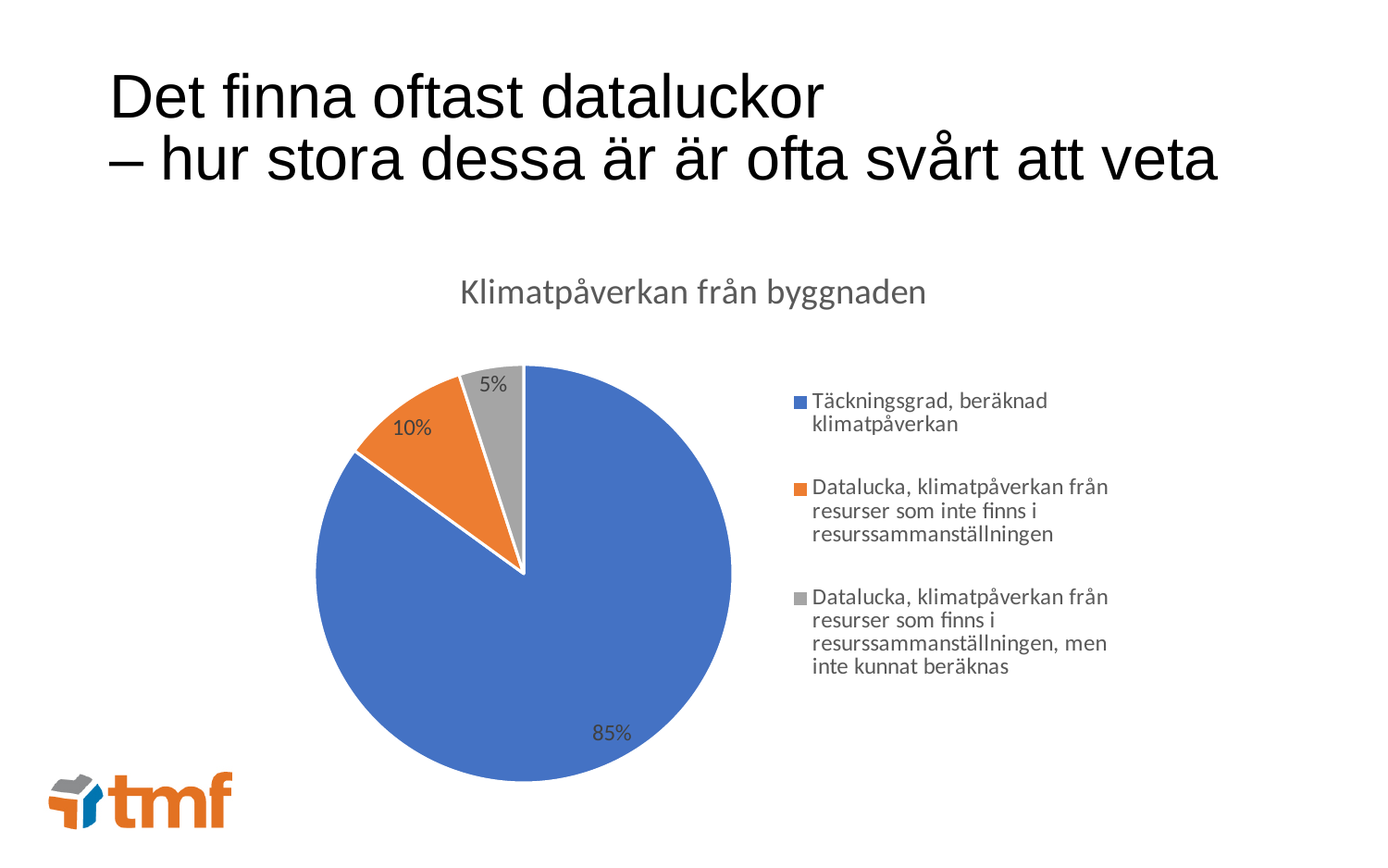
Which is larger: the 'Datalucka, klimatpåverkan från resurser som inte finns i resurssammanställningen' slice or the 'Datalucka, klimatpåverkan från resurser som finns i resurssammanställningen, men inte kunnat beräknas' slice? Datalucka, klimatpåverkan från resurser som inte finns i resurssammanställningen What is the title of the chart? Klimatpåverkan från byggnaden What share of the pie is 'Datalucka, klimatpåverkan från resurser som inte finns i resurssammanställningen'? 10% Which category has the smallest slice of the pie? Datalucka, klimatpåverkan från resurser som finns i resurssammanställningen, men inte kunnat beräknas What share of the pie is 'Täckningsgrad, beräknad klimatpåverkan'? 85% How many entries does the legend list? 3 Which category has the largest slice of the pie? Täckningsgrad, beräknad klimatpåverkan What is the difference in percentage points between the 'Täckningsgrad, beräknad klimatpåverkan' slice and the 'Datalucka, klimatpåverkan från resurser som inte finns i resurssammanställningen' slice? 75 percentage points What type of chart is shown on the slide? pie chart What share of the pie is 'Datalucka, klimatpåverkan från resurser som finns i resurssammanställningen, men inte kunnat beräknas'? 5% How many slices does the pie chart have? 3 What colour is the slice for 'Täckningsgrad, beräknad klimatpåverkan'? blue